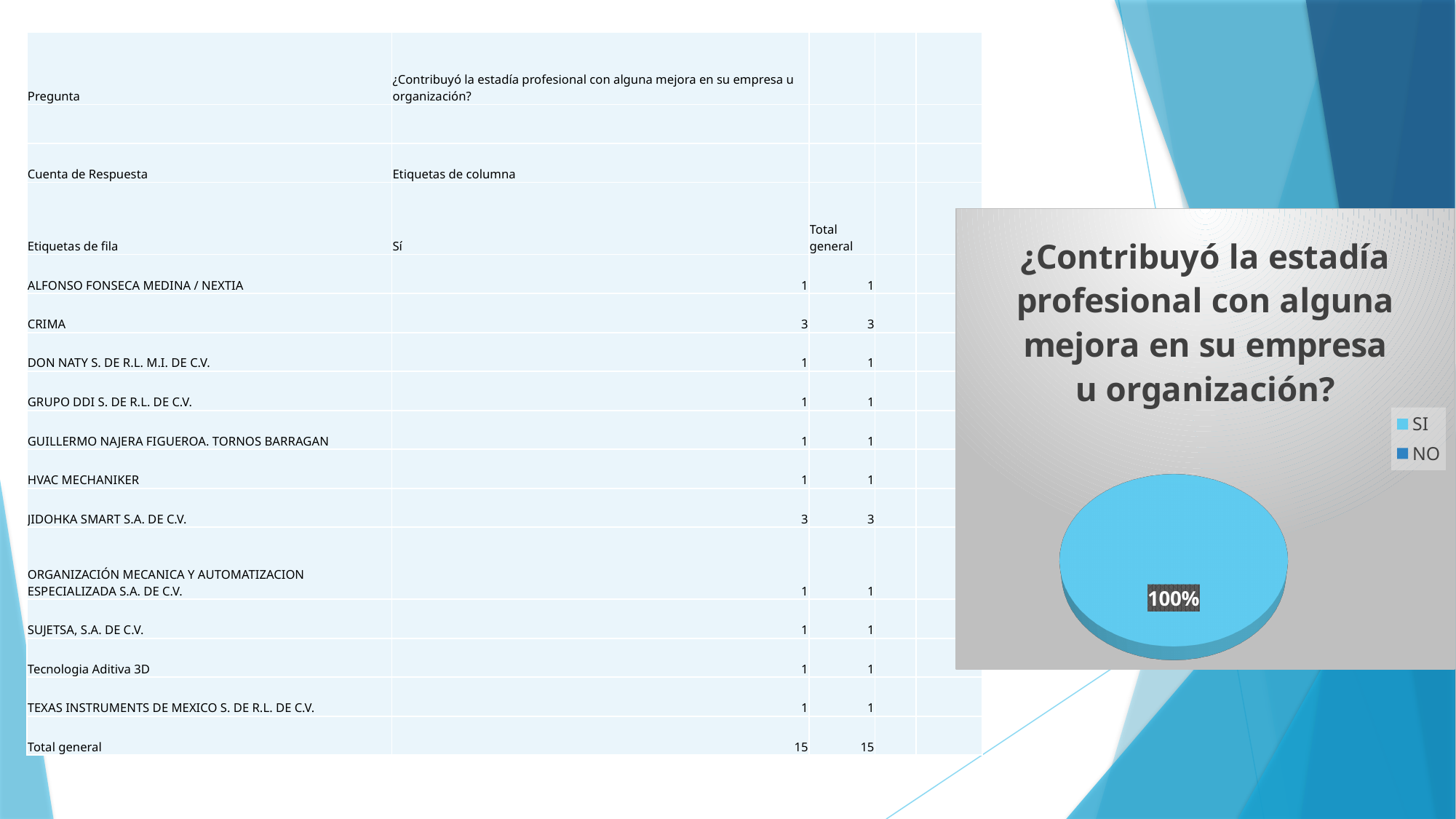
What share of the pie chart does the SI slice represent? 100% What kind of chart is shown on the right side of the slide? pie chart What colour is used for the SI category in the pie chart legend? light blue How many categories does the legend of the pie chart list? 2 Which is larger in the pie chart, SI or NO? SI What is the title of the pie chart? ¿Contribuyó la estadía profesional con alguna mejora en su empresa u organización? What data label is printed on the pie chart? 100% Is the share for SI in the pie chart greater or less than 50%? greater Which category has the largest slice in the pie chart? SI